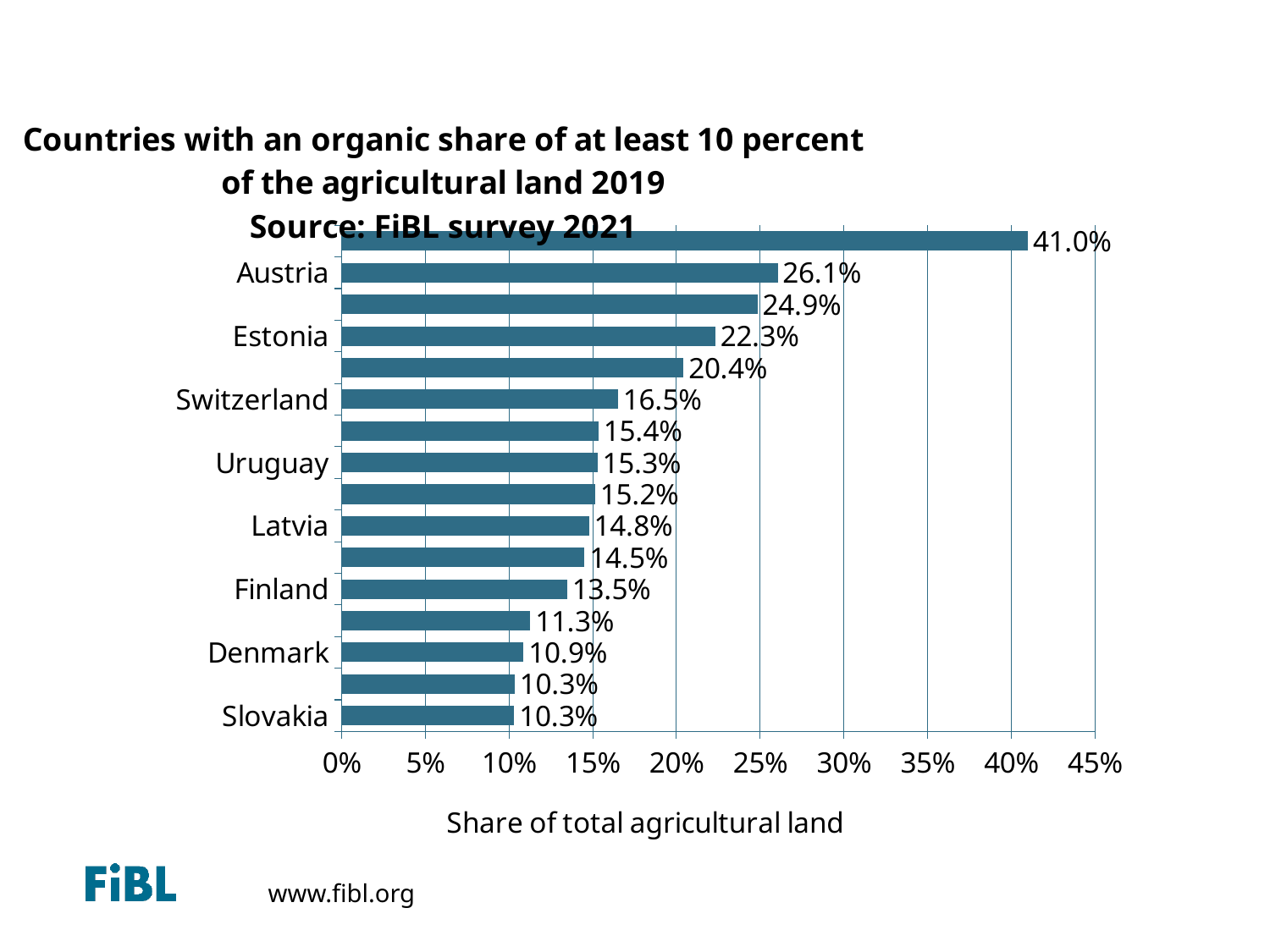
What is the highest value shown on the chart? 41.0% What is the title of the horizontal axis? Share of total agricultural land What is the organic share of agricultural land for Switzerland? 16.5% What is the organic share of agricultural land for Slovakia? 10.3% What is the organic share of agricultural land for Latvia? 14.8% What is the organic share of agricultural land for Uruguay? 15.3% Which has a larger organic share, Switzerland or Finland? Switzerland What is the organic share of agricultural land for Estonia? 22.3% What is the organic share of agricultural land for Austria? 26.1% What is the difference in percentage points between Austria's and Estonia's organic shares? 3.8 percentage points What is the organic share of agricultural land for Denmark? 10.9% What kind of chart is shown on the slide? Bar chart